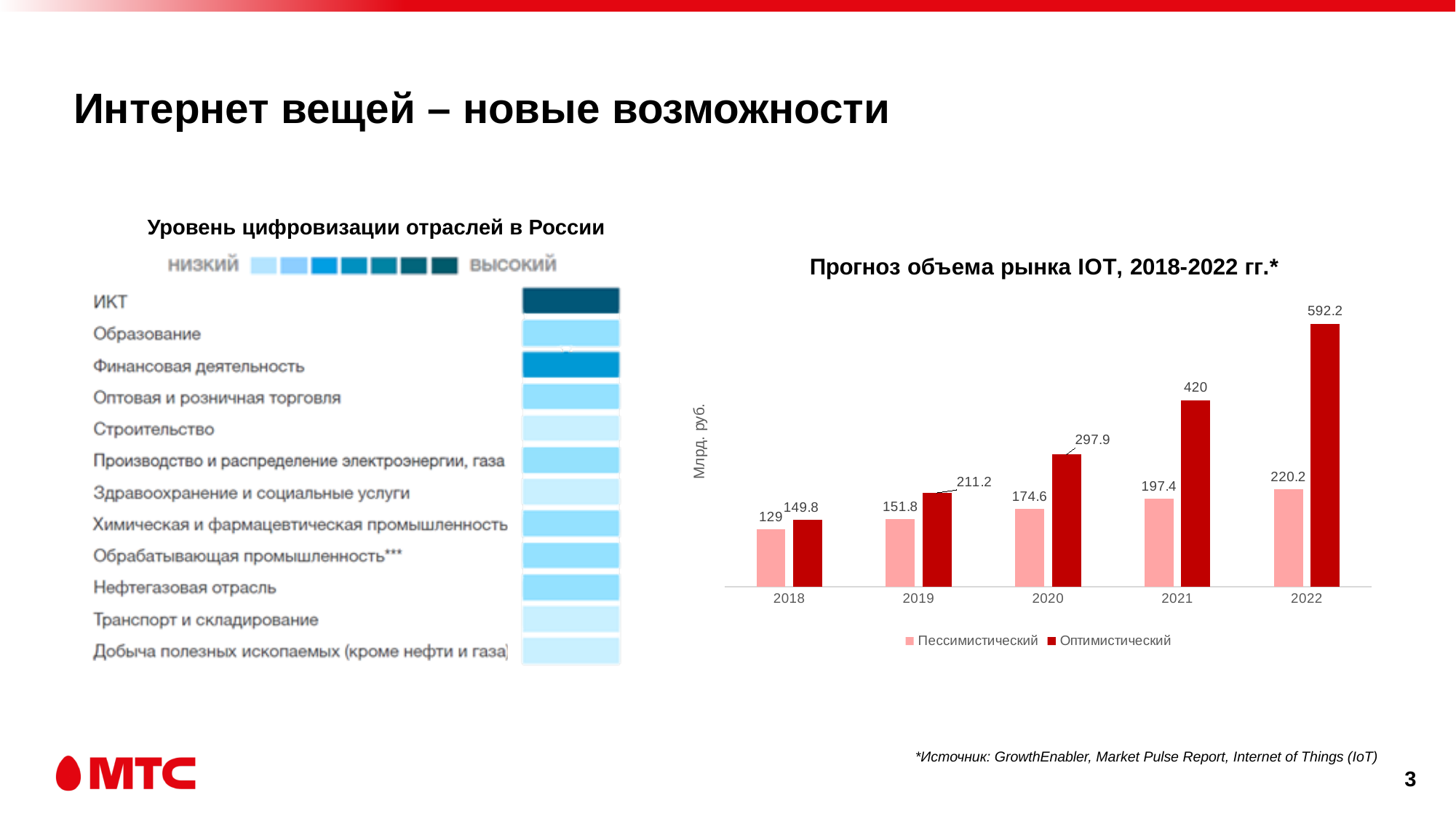
In the chart 'Прогноз объема рынка IOT, 2018-2022 гг.*', what is the value of the Пессимистический series for 2018? 129 In the chart 'Прогноз объема рынка IOT, 2018-2022 гг.*', which year has the lowest Пессимистический value? 2018 In the chart 'Прогноз объема рынка IOT, 2018-2022 гг.*', which is larger: the Пессимистический value for 2022 or the Оптимистический value for 2019? Пессимистический value for 2022 In the chart 'Прогноз объема рынка IOT, 2018-2022 гг.*', what is the value of the Оптимистический series for 2020? 297.9 How many series does the legend of the chart 'Прогноз объема рынка IOT, 2018-2022 гг.*' list? 2 What kind of chart is 'Прогноз объема рынка IOT, 2018-2022 гг.*'? Bar chart In the chart 'Прогноз объема рынка IOT, 2018-2022 гг.*', what is the value of the Оптимистический series for 2022? 592.2 In the chart 'Прогноз объема рынка IOT, 2018-2022 гг.*', what is the value of the Пессимистический series for 2021? 197.4 In the chart 'Прогноз объема рынка IOT, 2018-2022 гг.*', which year has the highest Оптимистический value? 2022 In the chart 'Прогноз объема рынка IOT, 2018-2022 гг.*', what is the difference between the Оптимистический and Пессимистический values for 2022? 372 How many years are shown on the x axis of the chart 'Прогноз объема рынка IOT, 2018-2022 гг.*'? 5 In the chart 'Прогноз объема рынка IOT, 2018-2022 гг.*', what is the difference between the Оптимистический values for 2021 and 2020? 122.1